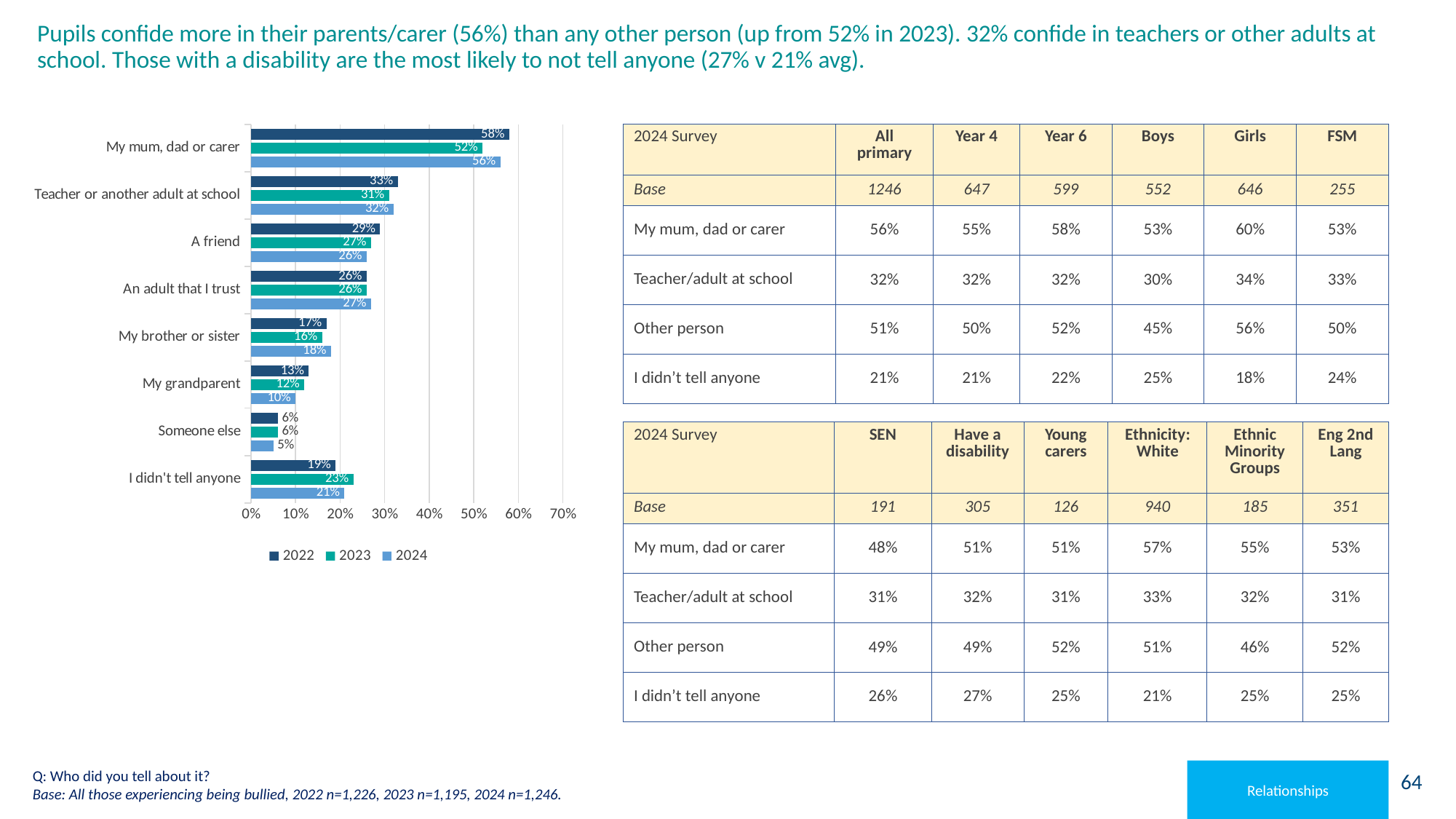
What is the difference between the 2022 and 2023 values for 'My mum, dad or carer'? 6% What kind of chart is shown on the slide? Bar chart What is the 2024 value for 'My grandparent'? 10% Which category has the highest 2024 value? My mum, dad or carer How many series does the chart's legend list? 3 Which is larger for 'My brother or sister': the 2023 value or the 2024 value? 2024 What are the series names listed in the chart's legend? 2022, 2023, 2024 What is the 2024 value for 'My mum, dad or carer'? 56% What is the 2023 value for 'I didn't tell anyone'? 23% How many categories are shown on the chart? 8 What is the 2022 value for 'A friend'? 29% Which category has the lowest 2022 value? Someone else